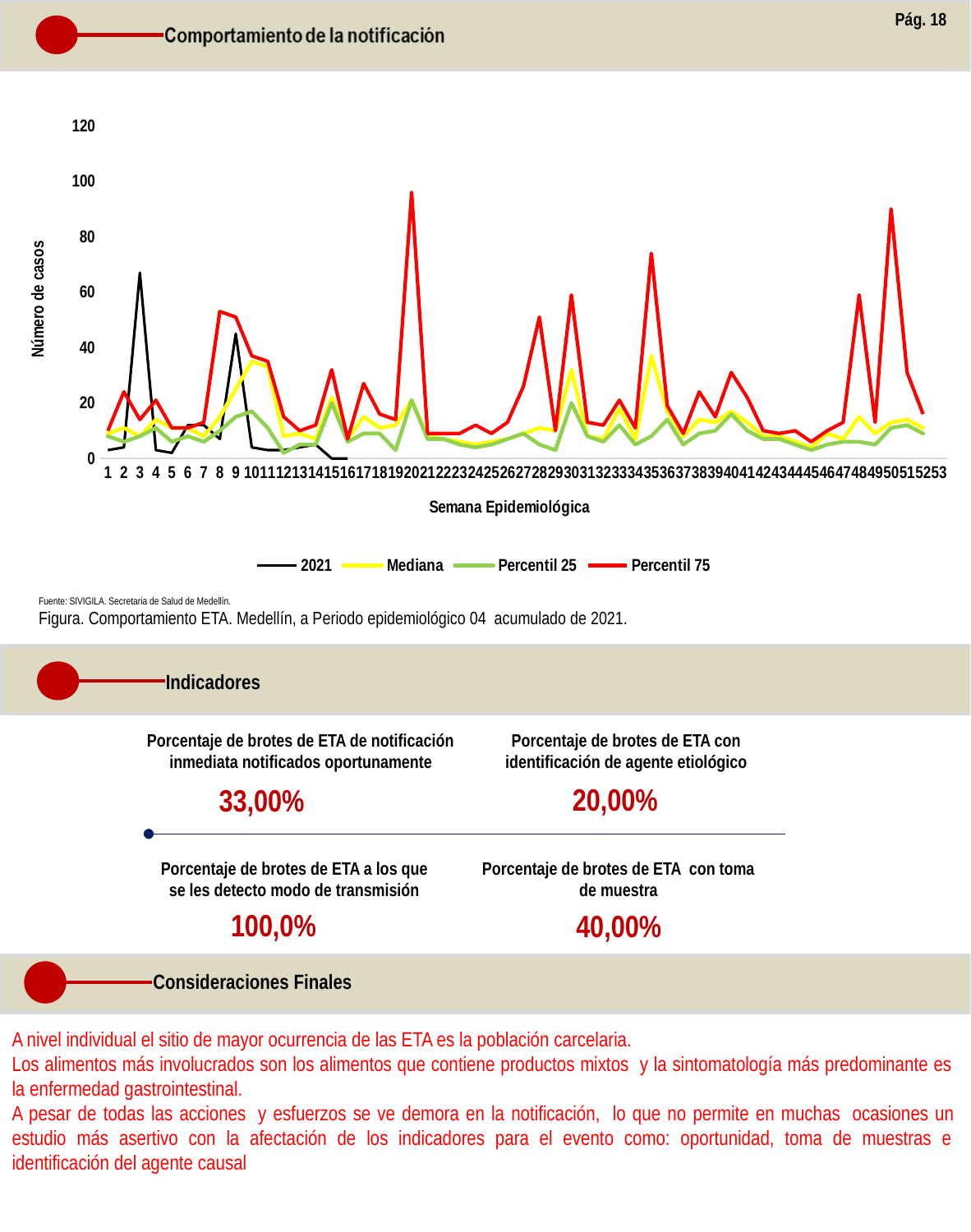
How many series does the chart legend list? 4 Is the value of Percentil 75 at week 50 greater or less than 80? greater How many epidemiological weeks are shown on the x axis of the chart? 53 Is the value of Mediana at week 20 greater or less than 40? less What is the title of the y axis of the chart? Número de casos What kind of chart is shown on the slide? line chart What is the title of the x axis of the chart? Semana Epidemiológica Is the value of Percentil 75 at week 20 greater or less than 80? greater Which is larger for Percentil 75: the value at week 20 or the value at week 28? week 20